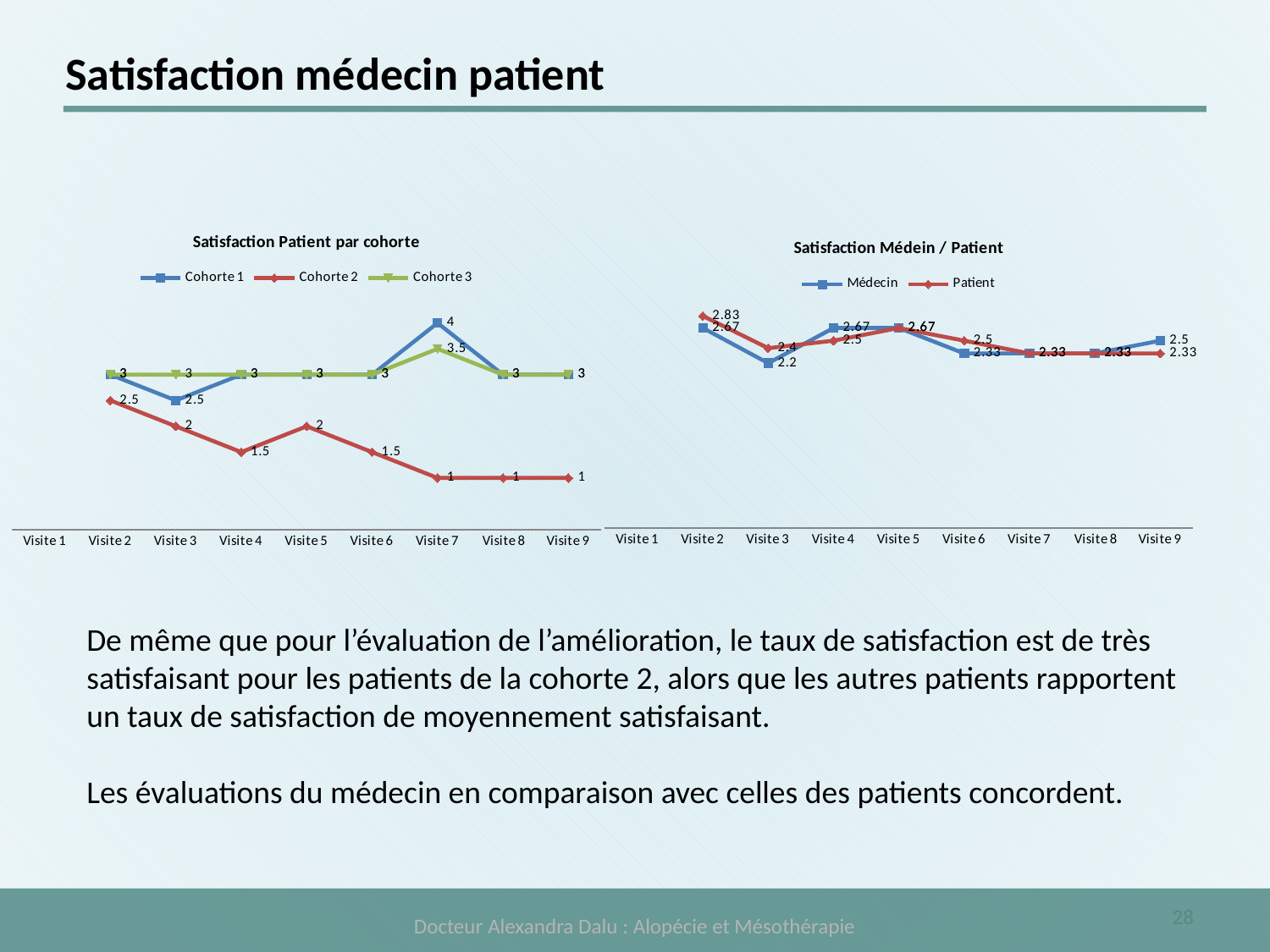
In the 'Satisfaction Médein / Patient' chart, how many visits are labelled on the x axis? 9 In the 'Satisfaction Patient par cohorte' chart, how many series does the legend list? 3 In the 'Satisfaction Patient par cohorte' chart, what is the value for Cohorte 3 at Visite 7? 3.5 In the 'Satisfaction Patient par cohorte' chart, what is the value for Cohorte 1 at Visite 7? 4 In the 'Satisfaction Patient par cohorte' chart, what is the value for Cohorte 2 at Visite 4? 1.5 In the 'Satisfaction Patient par cohorte' chart, does Cohorte 2 generally rise or fall from Visite 2 to Visite 9? Fall In the 'Satisfaction Patient par cohorte' chart, what kind of chart is shown? Line chart In the 'Satisfaction Patient par cohorte' chart, at which visit does Cohorte 1 reach its highest value? Visite 7 In the 'Satisfaction Médein / Patient' chart, what is the value for Médecin at Visite 3? 2.2 In the 'Satisfaction Médein / Patient' chart, which series has the larger value at Visite 9, Médecin or Patient? Médecin In the 'Satisfaction Médein / Patient' chart, what is the value for Patient at Visite 2? 2.83 In the 'Satisfaction Patient par cohorte' chart, what is the difference between Cohorte 1 and Cohorte 2 at Visite 7? 3